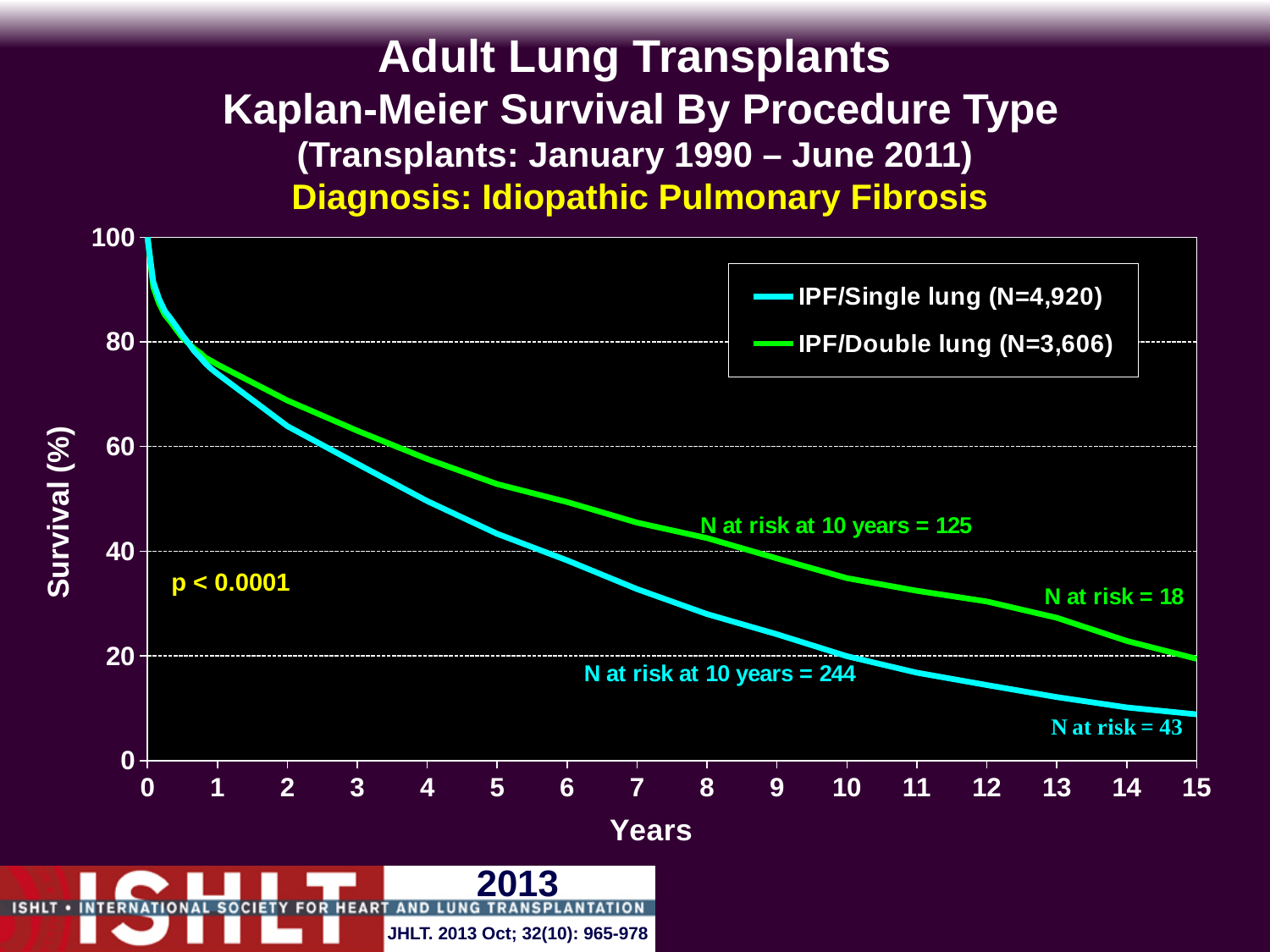
Do the survival curves rise or fall as years increase? fall What is the N at risk at 10 years for the IPF/Single lung group? 244 What p-value is shown on the chart? p < 0.0001 Which group has higher survival at 10 years, IPF/Single lung or IPF/Double lung? IPF/Double lung Is the survival for IPF/Single lung at 15 years greater or less than 20%? less What is the N at risk at the end of follow-up for the IPF/Single lung group? 43 What is the N at risk at 10 years for the IPF/Double lung group? 125 What kind of chart is shown on the slide? line chart What is the N at risk at the end of follow-up for the IPF/Double lung group? 18 What is the sample size (N) for the IPF/Single lung group shown in the legend? 4,920 How many series does the legend list? 2 Is the survival for IPF/Double lung at 10 years greater or less than 20%? greater